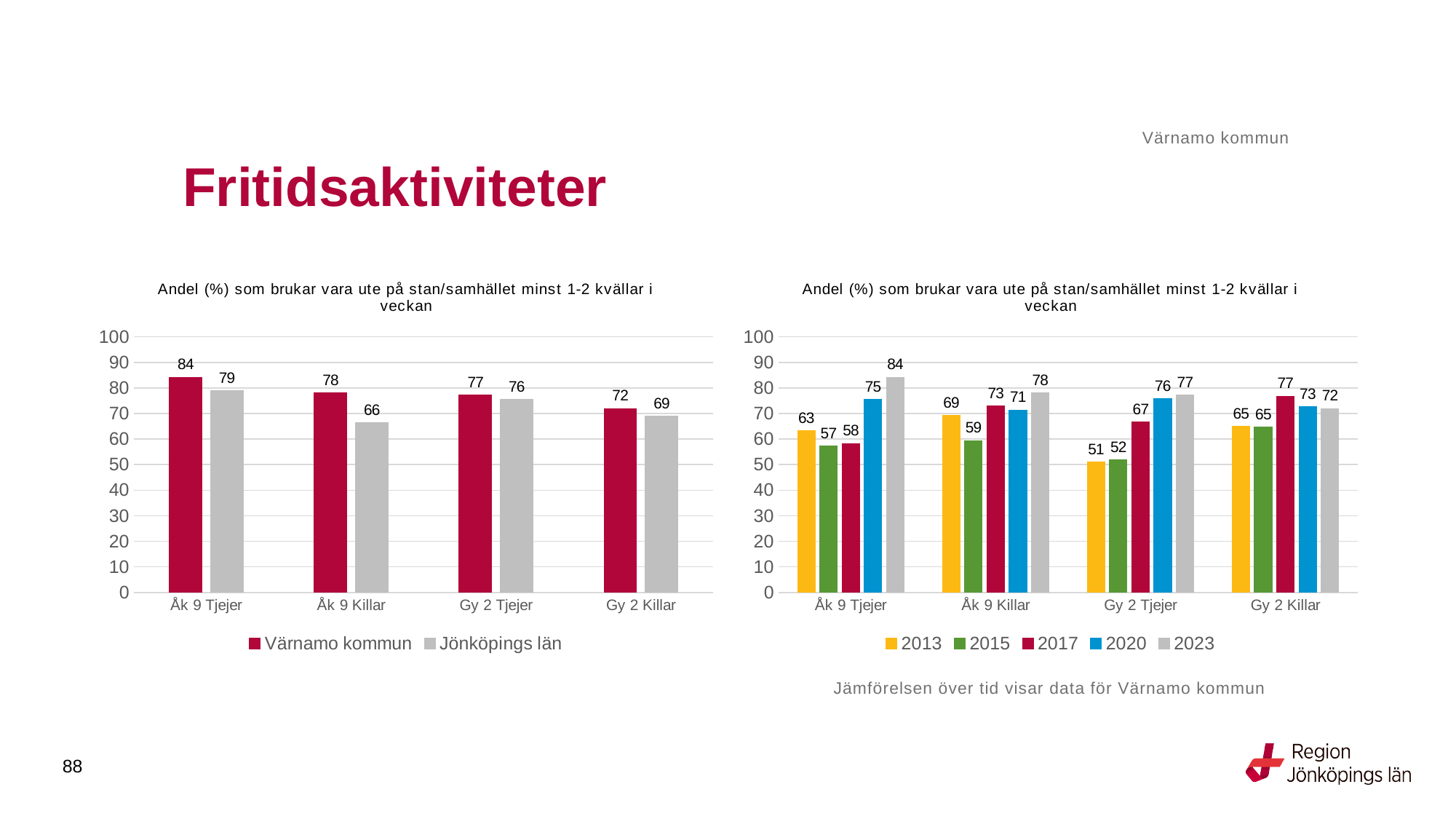
In the left chart, what is the value for Jönköpings län for Åk 9 Killar? 66 In the left chart, how many series does the legend list? 2 In the right chart, what is the value for 2013 for Gy 2 Tjejer? 51 What kind of chart is the left chart? Bar chart In the right chart, is the value for 2020 for Gy 2 Tjejer larger than the value for 2015 for Gy 2 Tjejer? Yes In the right chart, which year has the highest value for Gy 2 Killar? 2017 In the left chart, which category has the lowest value for Värnamo kommun? Gy 2 Killar In the right chart, what is the value for 2023 for Åk 9 Tjejer? 84 In the left chart, what is the difference between Värnamo kommun and Jönköpings län for Åk 9 Killar? 12 In the right chart, how many series does the legend list? 5 In the left chart, what is the value for Värnamo kommun for Åk 9 Tjejer? 84 In the right chart, what is the difference between the 2023 and 2013 values for Åk 9 Tjejer? 21